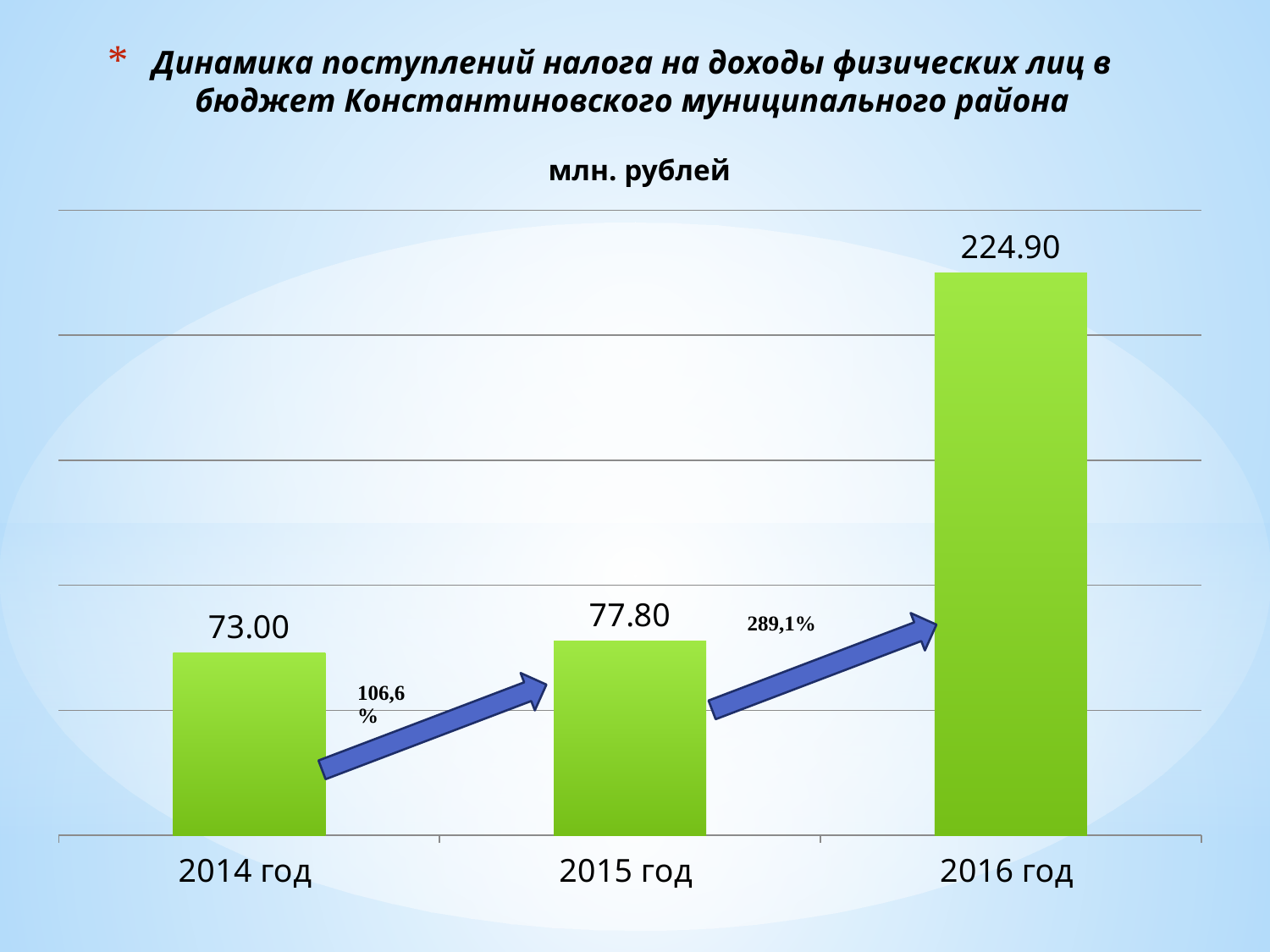
What is the value for 2014 год? 73.00 Which year has the lowest value? 2014 год What unit is given in the chart title? млн. рублей Which is larger, the value for 2015 год or the value for 2014 год? 2015 год What kind of chart is shown on the slide? bar chart What is the value for 2016 год? 224.90 Which year has the highest value? 2016 год What is the difference between the values for 2015 год and 2014 год? 4.80 What is the difference between the values for 2016 год and 2015 год? 147.10 How many years are shown on the chart? 3 Do the values rise or fall from 2014 год to 2016 год? rise What is the value for 2015 год? 77.80